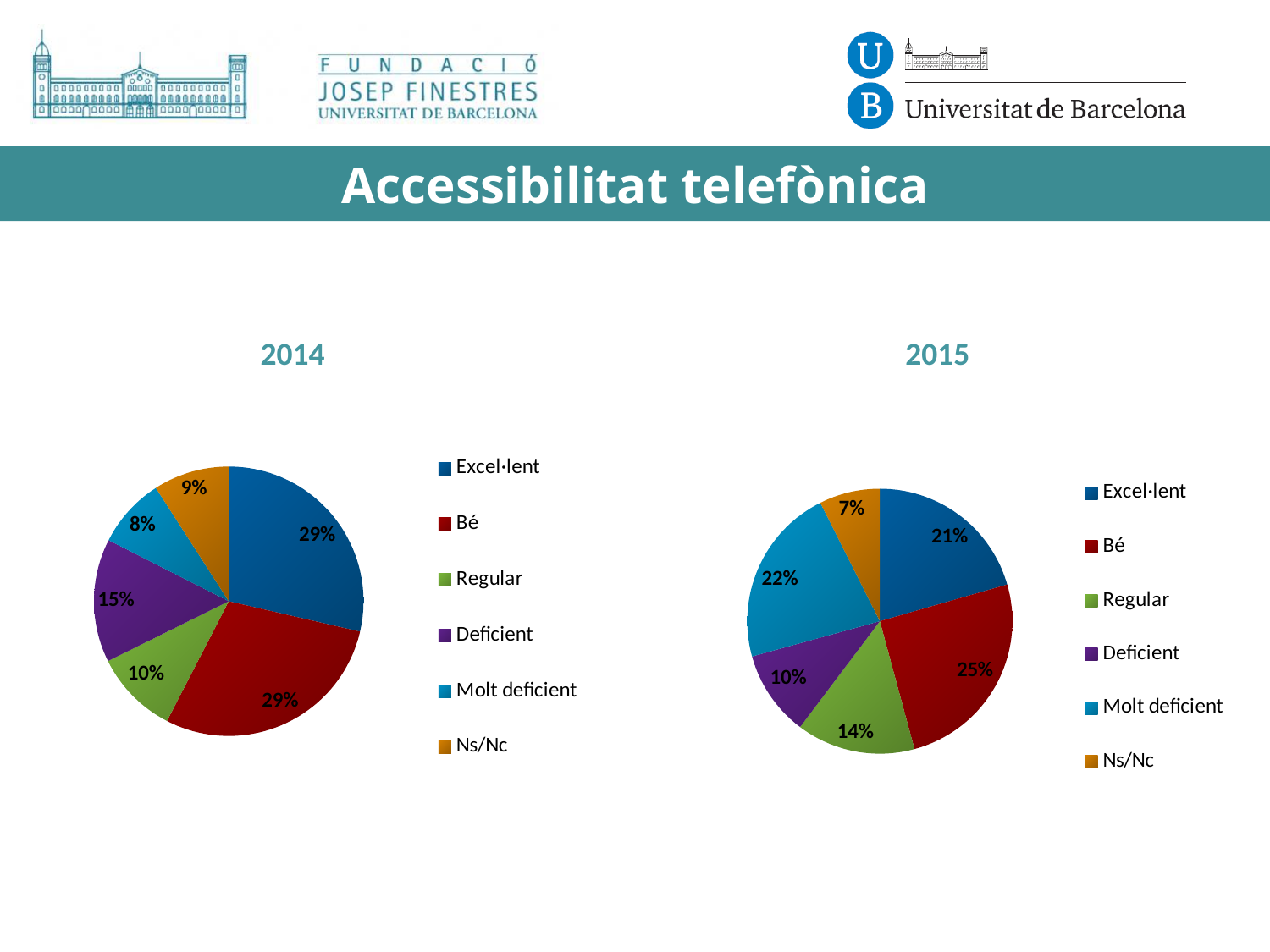
In the 2014 pie chart, what share does Ns/Nc have? 9% In the 2014 pie chart, which category has the smallest share? Molt deficient In the 2015 pie chart, which category has the largest share? Bé What is the title shown above the left chart? 2014 How many categories does the legend of the 2014 pie chart list? 6 Which is larger: the Molt deficient share in the 2014 chart or in the 2015 chart? 2015 In the 2015 pie chart, what share does Molt deficient have? 22% What type of chart is used for the 2015 data? Pie chart In the 2014 pie chart, what share does Deficient have? 15% What is the difference between the Excel·lent share in the 2014 chart and the Excel·lent share in the 2015 chart? 8% In the 2015 pie chart, what share does Regular have? 14% In the 2015 pie chart, which category has the smallest share? Ns/Nc